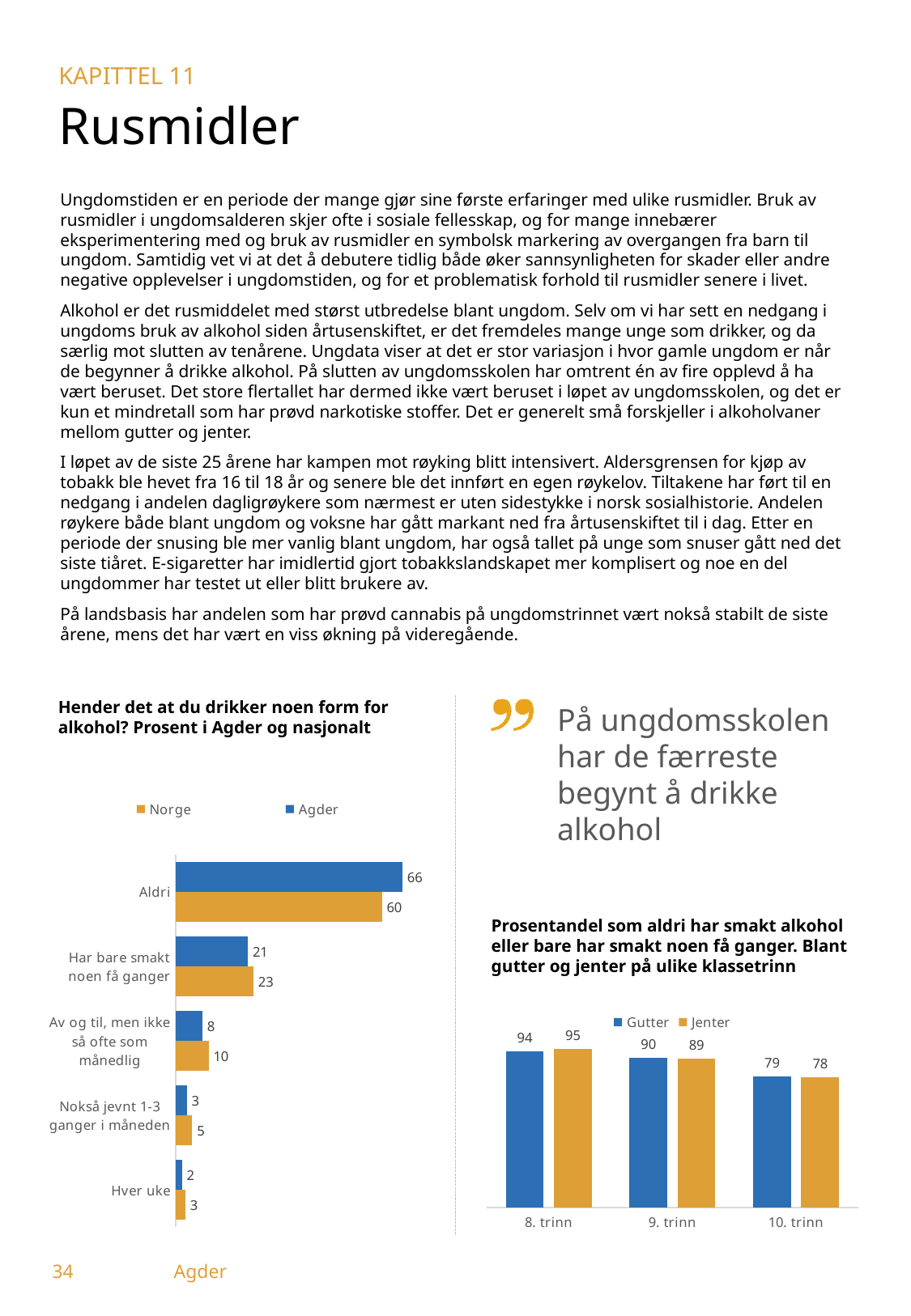
In the chart 'Prosentandel som aldri har smakt alkohol eller bare har smakt noen få ganger', what is the difference between the Gutter values for 8. trinn and 10. trinn? 15 In the chart 'Hender det at du drikker noen form for alkohol?', what is the Norge value for 'Har bare smakt noen få ganger'? 23 In the chart 'Prosentandel som aldri har smakt alkohol eller bare har smakt noen få ganger', do the Gutter values rise or fall from 8. trinn to 10. trinn? Fall In the chart 'Hender det at du drikker noen form for alkohol?', what is the Agder value for 'Aldri'? 66 How many categories are shown in the chart 'Hender det at du drikker noen form for alkohol?'? 5 What type of chart is 'Hender det at du drikker noen form for alkohol?'? Bar chart How many series does the legend list in the chart 'Prosentandel som aldri har smakt alkohol eller bare har smakt noen få ganger'? 2 In the chart 'Hender det at du drikker noen form for alkohol?', which is larger for 'Av og til, men ikke så ofte som månedlig': Norge or Agder? Norge In the chart 'Hender det at du drikker noen form for alkohol?', which category has the highest Agder value? Aldri In the chart 'Hender det at du drikker noen form for alkohol?', which category has the lowest Norge value? Hver uke In the chart 'Hender det at du drikker noen form for alkohol?', what is the difference between the Agder and Norge values for 'Aldri'? 6 In the chart 'Prosentandel som aldri har smakt alkohol eller bare har smakt noen få ganger', what is the Jenter value for 9. trinn? 89